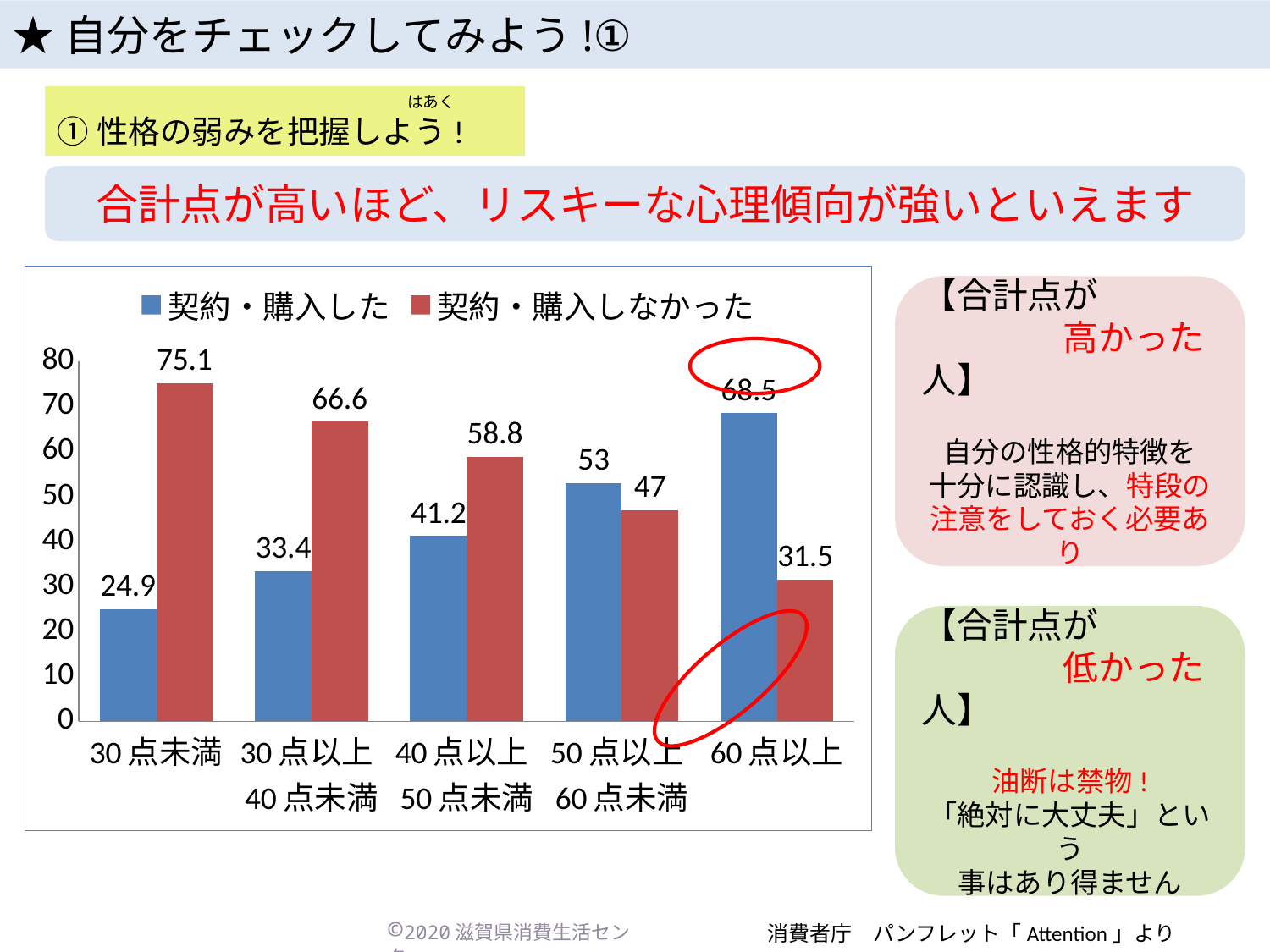
What is the value for 契約・購入した in the 40点以上50点未満 category? 41.2 Is the value for 契約・購入した in the 30点以上40点未満 category greater or less than 40? less What kind of chart is shown on the slide? bar chart What is the value for 契約・購入した in the 60点以上 category? 68.5 How many categories are shown on the x axis? 5 Which category has the highest value for 契約・購入した? 60点以上 Which category has the lowest value for 契約・購入しなかった? 60点以上 Do the values for 契約・購入した rise or fall from 30点未満 to 60点以上? rise What is the value for 契約・購入しなかった in the 30点未満 category? 75.1 How many series does the legend list? 2 What is the difference between 契約・購入しなかった and 契約・購入した in the 30点未満 category? 50.2 In the 50点以上60点未満 category, which series has the larger value, 契約・購入した or 契約・購入しなかった? 契約・購入した